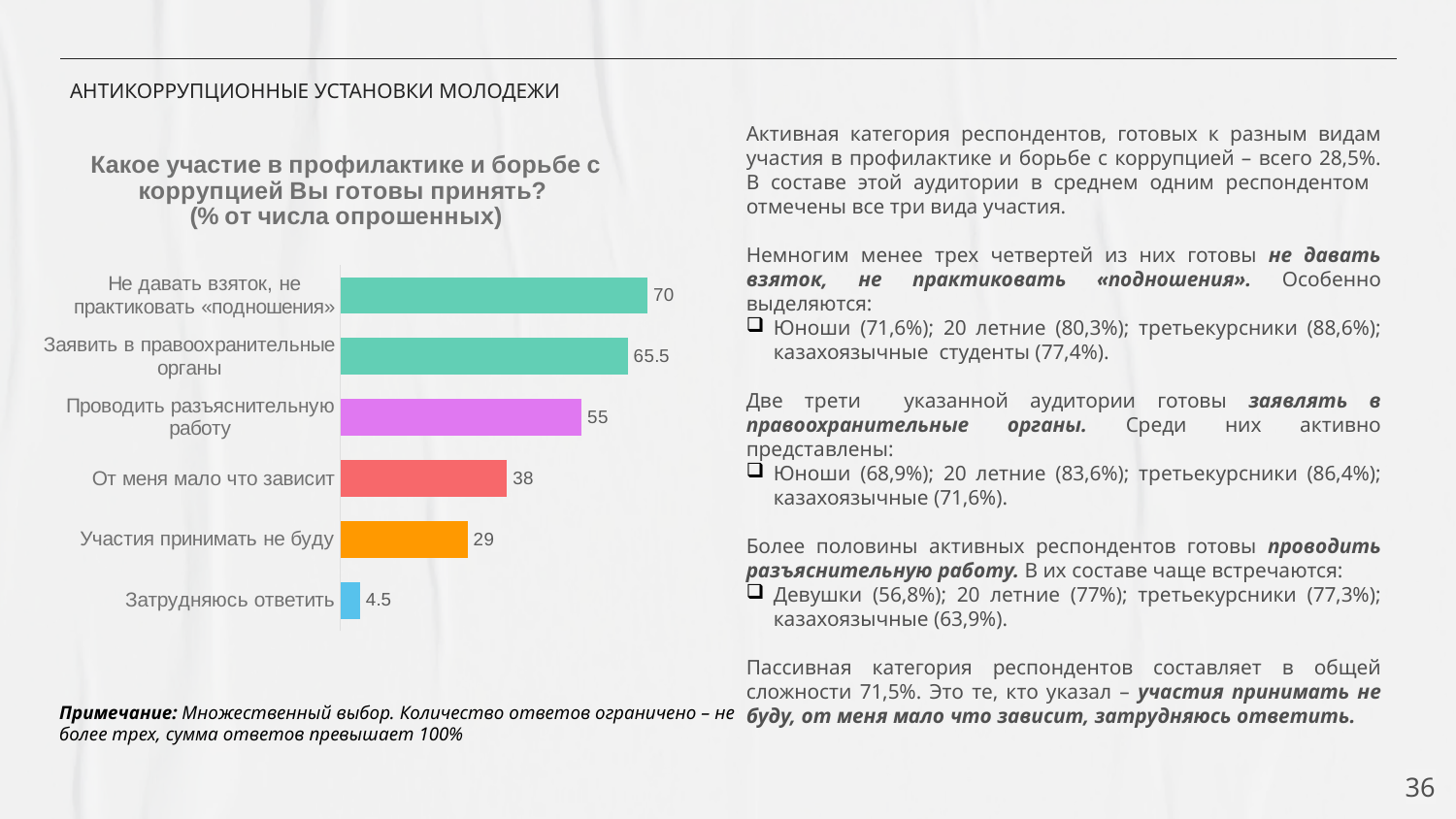
What is the difference between «Проводить разъяснительную работу» and «От меня мало что зависит»? 17 How many categories are shown in the chart? 6 Which category has the lowest value? Затрудняюсь ответить What is the difference between «Не давать взяток, не практиковать «подношения»» and «Заявить в правоохранительные органы»? 4.5 Which is larger: «От меня мало что зависит» or «Участия принимать не буду»? От меня мало что зависит What is the value for «Участия принимать не буду»? 29 What kind of chart is shown on the slide? Bar chart What is the value for «Заявить в правоохранительные органы»? 65.5 What is the value for «Не давать взяток, не практиковать «подношения»»? 70 What colour is the bar for «Проводить разъяснительную работу»? Purple Which category has the highest value? Не давать взяток, не практиковать «подношения» What is the value for «Затрудняюсь ответить»? 4.5